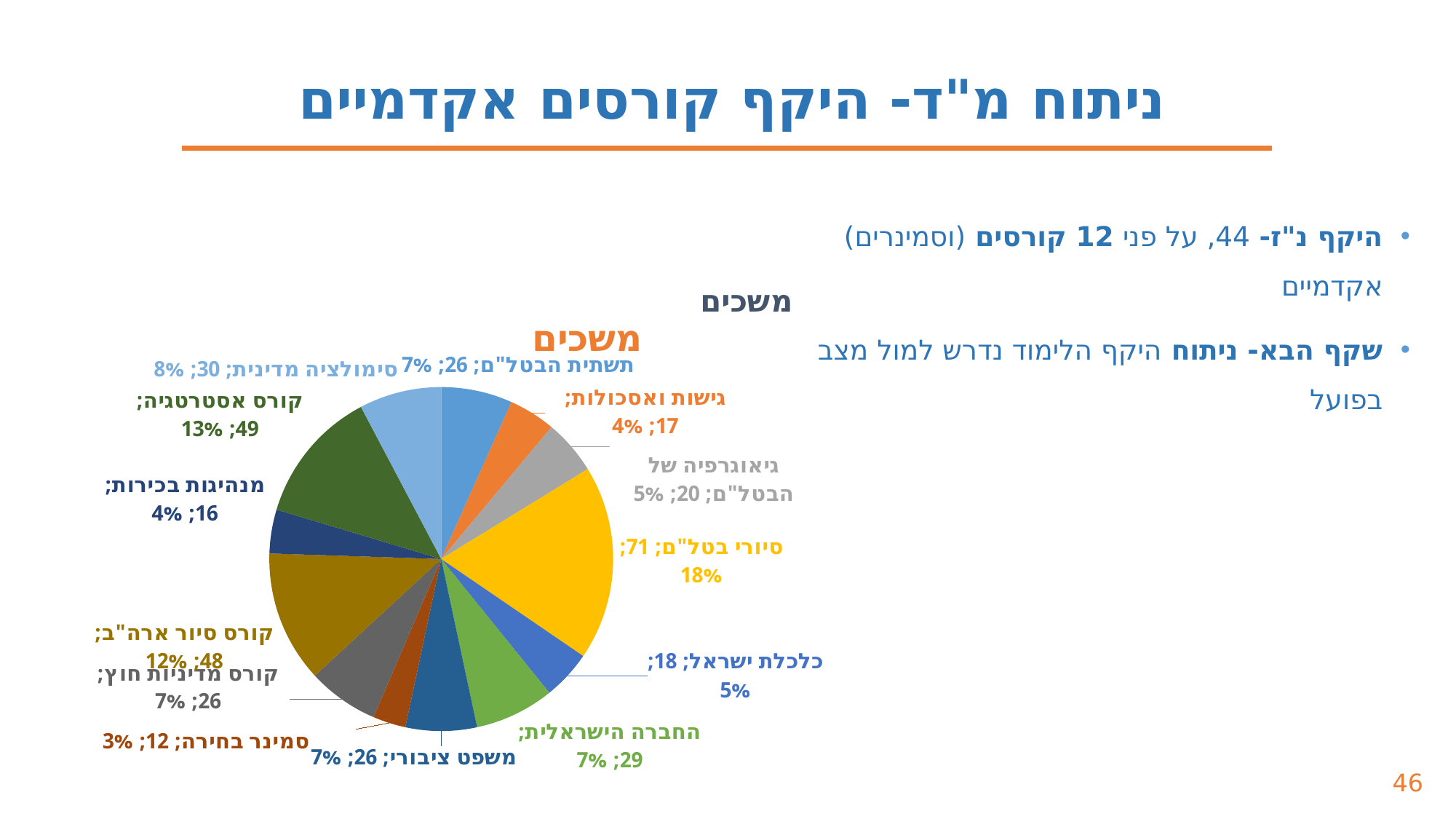
What is the value for סיורי בטל"ם in the pie chart? 71 What kind of chart is shown on the slide? pie chart Which category has the largest slice in the pie chart? סיורי בטל"ם What is the difference between the values for סיורי בטל"ם and קורס סיור ארה"ב? 23 What is the value for גיאוגרפיה של הבטל"ם in the pie chart? 20 What is the value for סמינר בחירה in the pie chart? 12 What is the title of the pie chart? משכים How many slices does the pie chart have? 13 What is the value for קורס אסטרטגיה in the pie chart? 49 Which category has the smallest slice in the pie chart? סמינר בחירה What share of the pie does סיורי בטל"ם represent? 18% What share of the pie does סימולציה מדינית represent? 8%